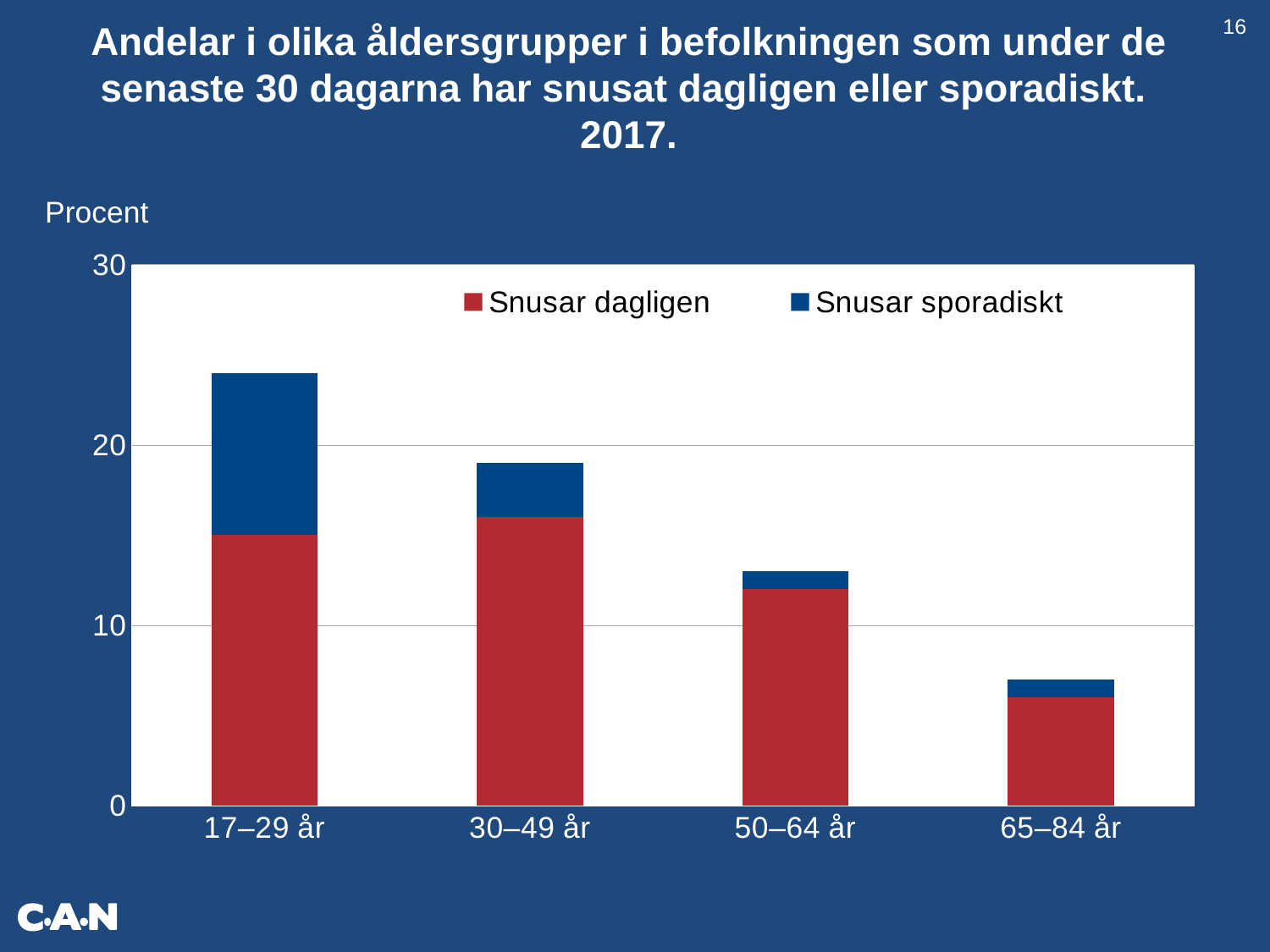
Which age group has the lowest total bar? 65–84 år Is the total bar for 17–29 år greater or less than 20? greater How many series does the legend list? 2 Which age group has the highest total bar? 17–29 år Is the 'Snusar dagligen' value for 17–29 år greater or less than 10? greater What label is shown above the y axis? Procent Is the total bar for 50–64 år greater or less than 10? greater How many age groups are shown on the x axis? 4 Which age group has the larger 'Snusar sporadiskt' segment, 17–29 år or 30–49 år? 17–29 år What kind of chart is shown on the slide? Stacked bar chart Do the total bar heights rise or fall as age increases along the x axis? fall